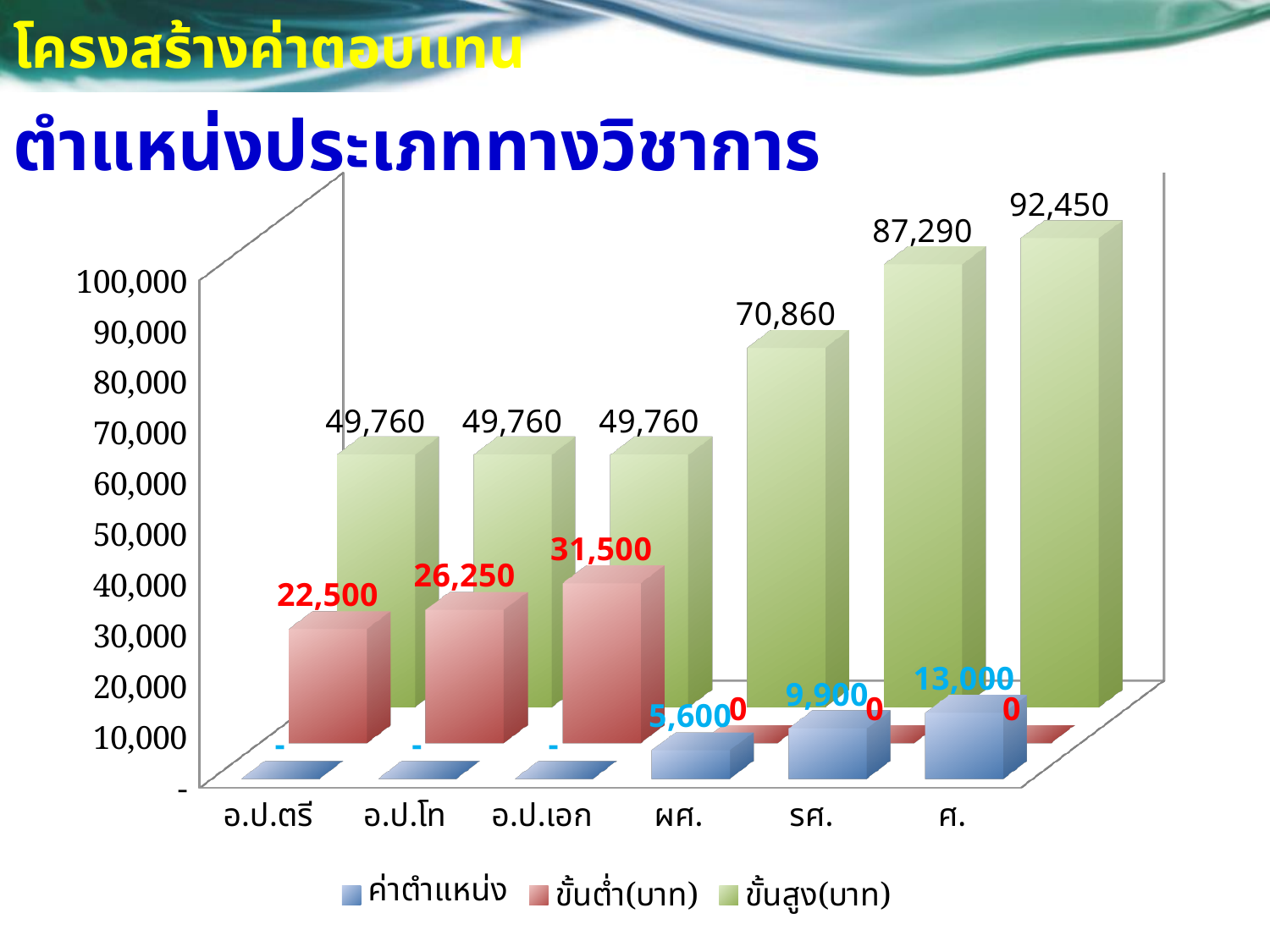
Which category has the highest ขั้นสูง(บาท) value? ศ. Which is larger, the ค่าตำแหน่ง value for ศ. or for ผศ.? ศ. How many categories are shown on the x axis? 6 What is the difference between the ขั้นต่ำ(บาท) values for อ.ป.เอก and อ.ป.ตรี? 9,000 What kind of chart is shown on the slide? Bar chart What is the ค่าตำแหน่ง value for รศ.? 9,900 What is the ขั้นต่ำ(บาท) value for อ.ป.โท? 26,250 How many series does the legend list? 3 What is the ขั้นสูง(บาท) value for ศ.? 92,450 Which category has the highest ขั้นต่ำ(บาท) value? อ.ป.เอก What is the ขั้นสูง(บาท) value for ผศ.? 70,860 What is the difference between the ขั้นสูง(บาท) values for ศ. and รศ.? 5,160